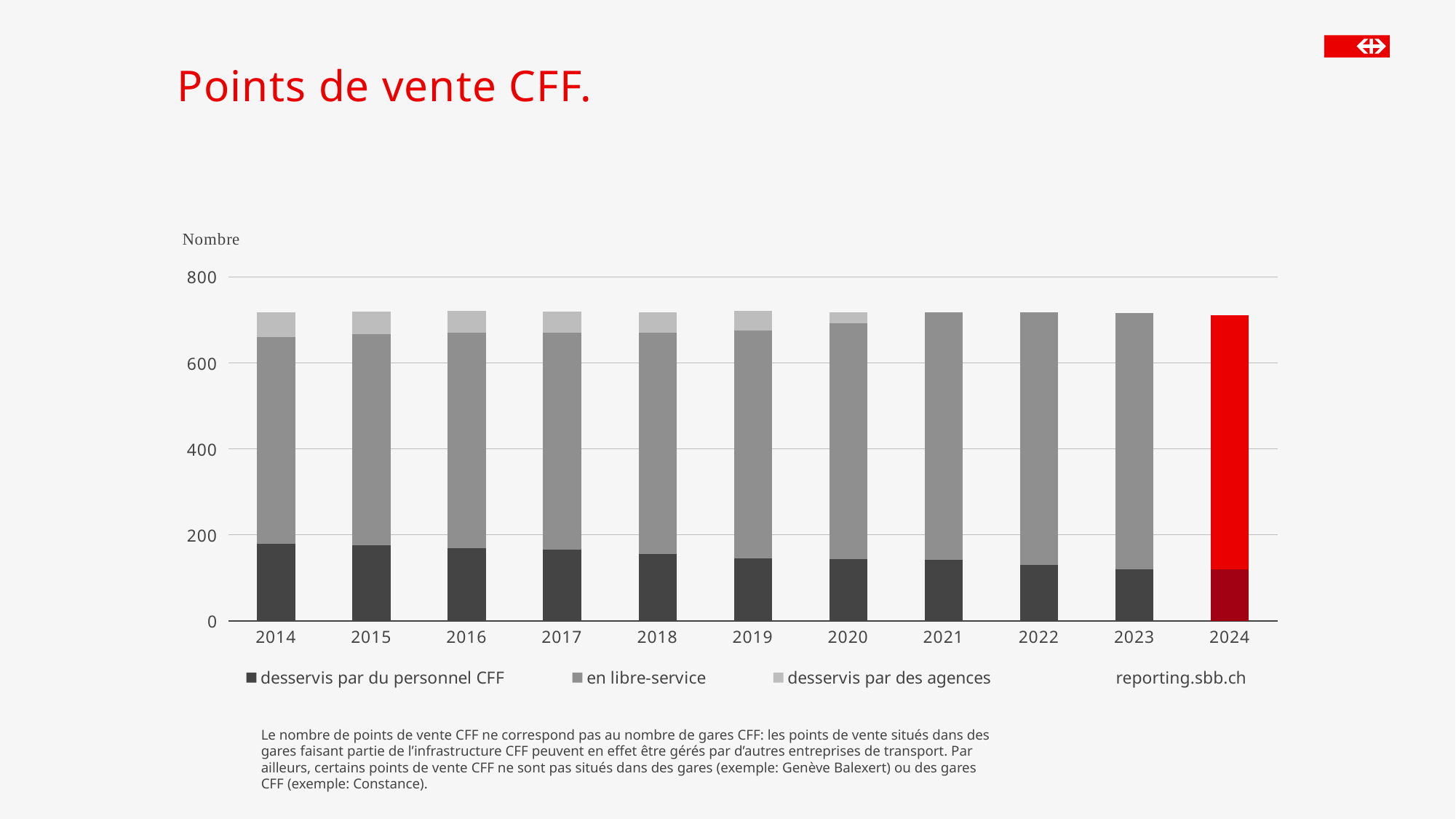
How many years are shown on the x axis of the chart? 11 What is the first year shown on the x axis? 2014 What kind of chart is shown on the slide? stacked bar chart Is the value for 'desservis par du personnel CFF' in 2014 larger or smaller than in 2024? larger How many series does the legend list? 3 Is the total height of the stacked bar for 2014 greater or less than 600? greater Is the total height of the stacked bar for 2024 greater or less than 800? less Is the value for 'desservis par du personnel CFF' in 2014 greater or less than 200? less What is the title of the slide containing the chart? Points de vente CFF. Which year's bar is drawn in red rather than grey? 2024 Does the 'desservis par du personnel CFF' segment rise or fall from 2014 to 2024? fall